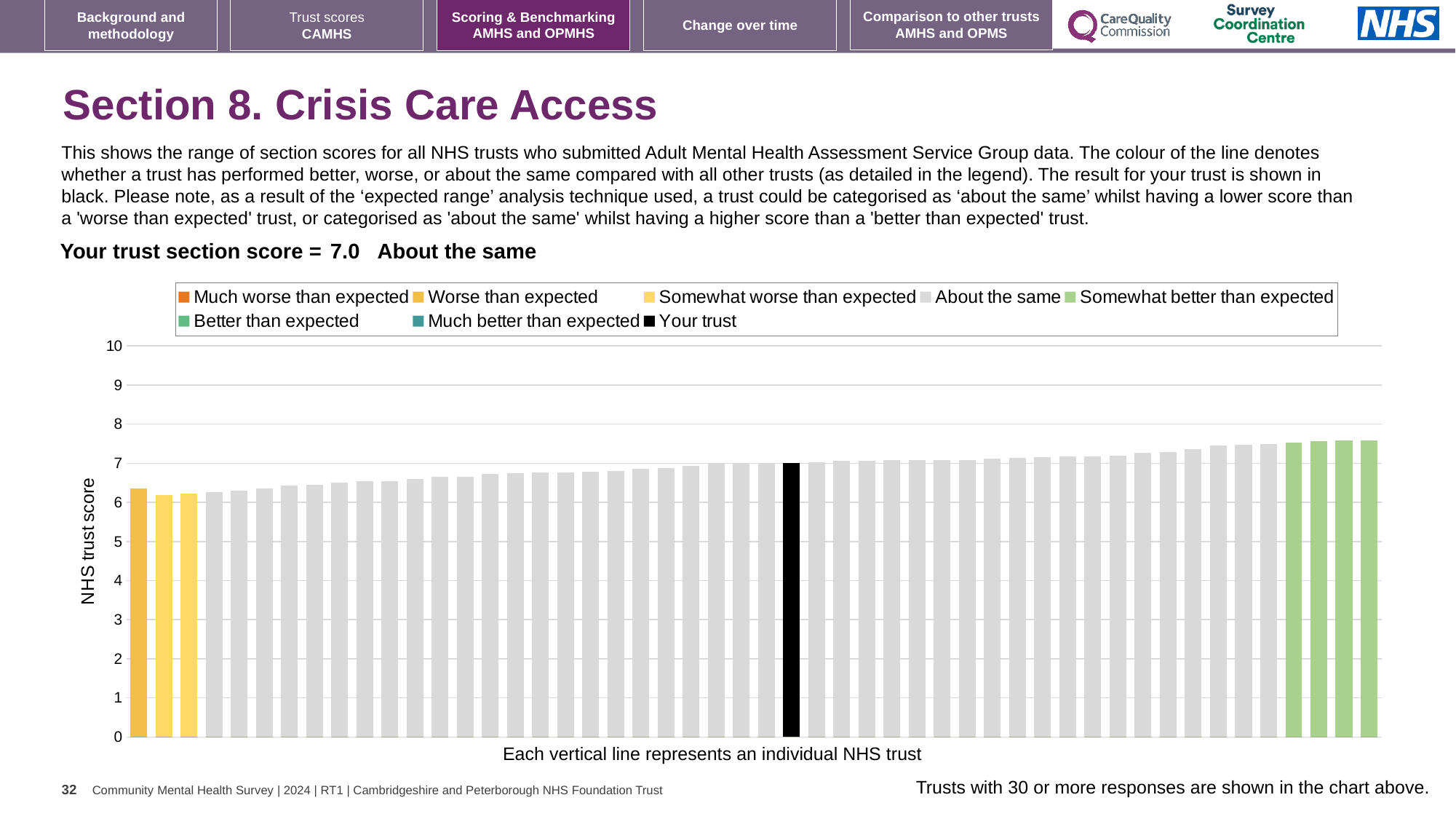
What is the label on the vertical axis of the chart? NHS trust score What kind of chart is shown on the slide? bar chart Do the bar values rise or fall from left to right along the x axis? rise Is the value of the shortest bar greater or less than 6? greater What colour is used for the bar representing your trust? black What is the section score for your trust shown on the slide? 7.0 How many bars are coloured light yellow (somewhat worse than expected)? 2 How many entries does the chart legend list? 8 How many bars are coloured green (somewhat better than expected)? 4 Which category is your trust placed in for this section? About the same Is the value of the black bar (your trust) greater or less than 5? greater Is the value of the tallest bar greater or less than 7? greater